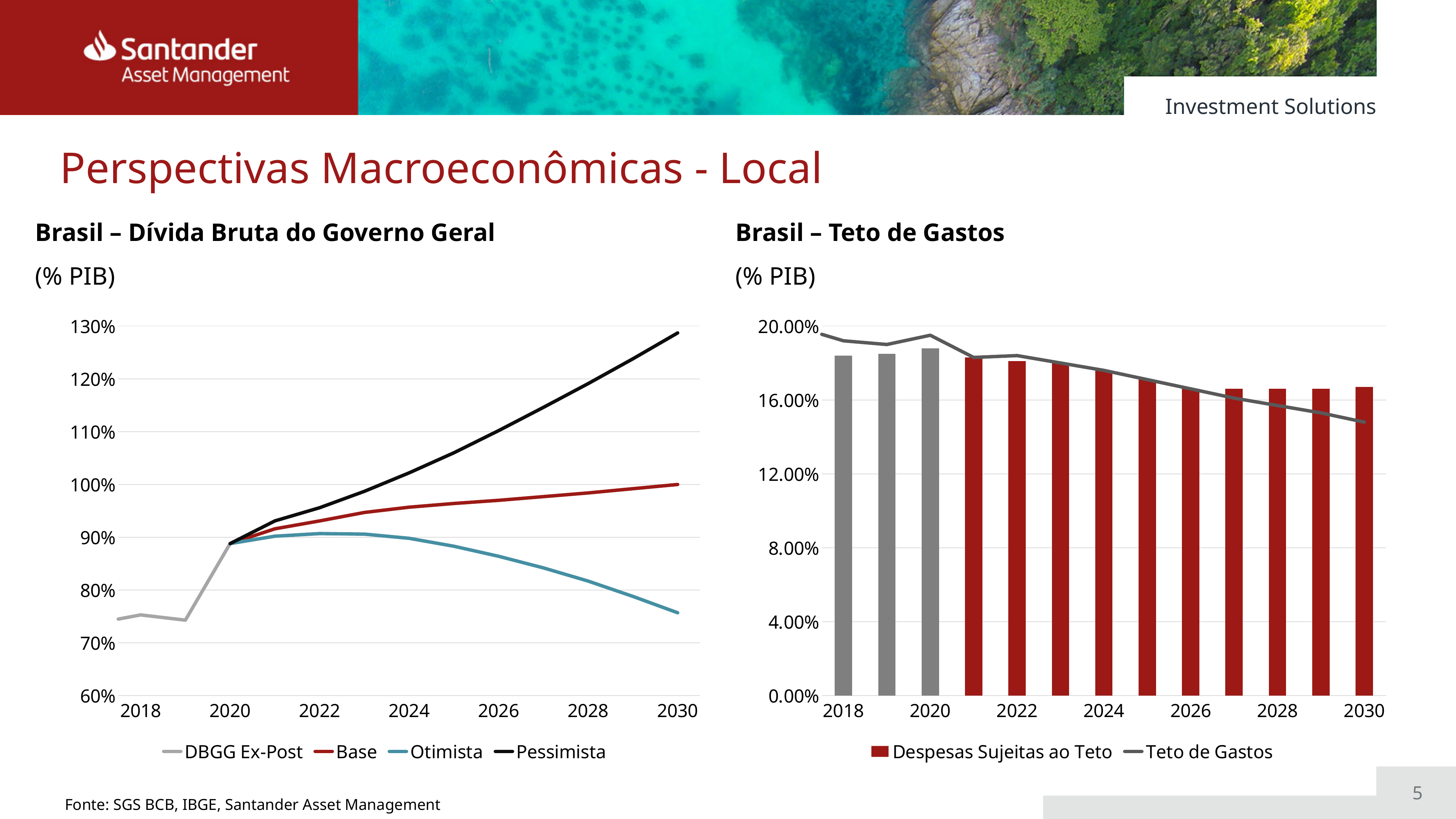
On the chart titled 'Brasil – Dívida Bruta do Governo Geral', which series has the highest value in 2030? Pessimista On the chart titled 'Brasil – Teto de Gastos', how many series does the legend list? 2 On the chart titled 'Brasil – Dívida Bruta do Governo Geral', is the Otimista value in 2030 greater or less than 80%? less On the chart titled 'Brasil – Dívida Bruta do Governo Geral', does the Pessimista series rise or fall from 2020 to 2030? Rises On the chart titled 'Brasil – Teto de Gastos', is the Teto de Gastos value in 2030 greater or less than 16.00%? less On the chart titled 'Brasil – Dívida Bruta do Governo Geral', how many series does the legend list? 4 On the chart titled 'Brasil – Dívida Bruta do Governo Geral', is the Pessimista value in 2030 greater or less than 120%? greater On the chart titled 'Brasil – Teto de Gastos', does the Teto de Gastos line rise or fall from 2020 to 2030? Falls On the chart titled 'Brasil – Dívida Bruta do Governo Geral', which series has the lowest value in 2030? Otimista On the chart titled 'Brasil – Teto de Gastos', in 2030 which is larger: Despesas Sujeitas ao Teto or Teto de Gastos? Despesas Sujeitas ao Teto On the chart titled 'Brasil – Teto de Gastos', how many bars are plotted? 13 On the chart titled 'Brasil – Dívida Bruta do Governo Geral', what kind of chart is it? Line chart